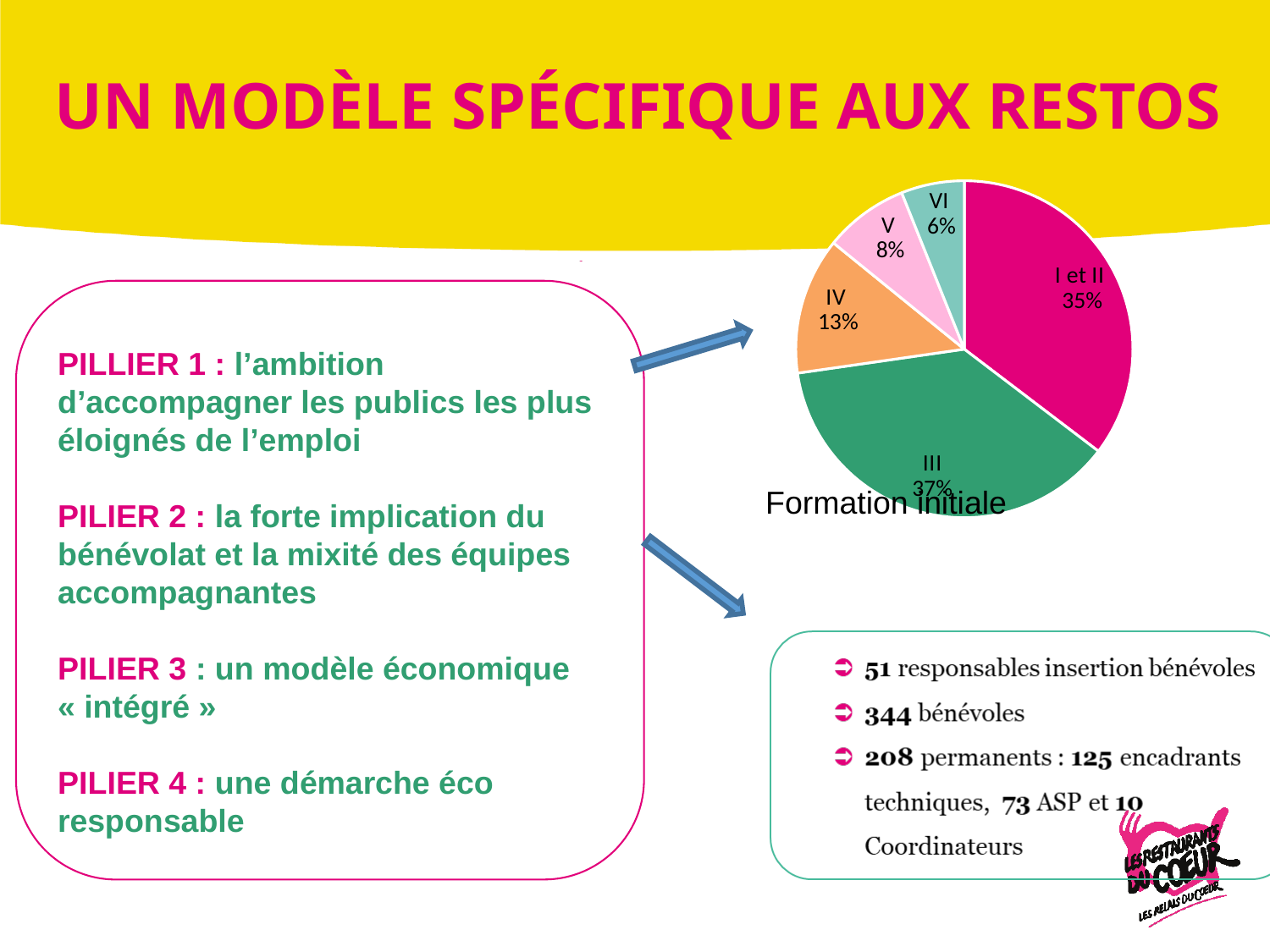
What is the difference in percentage points between the "IV" slice and the "V" slice? 5 Which slice of the pie chart is the largest? III What share of the pie does the slice labelled "VI" represent? 6% Which slice of the pie chart is the smallest? VI What kind of chart is shown on the slide? pie chart What share of the pie does the slice labelled "III" represent? 37% What share of the pie does the slice labelled "IV" represent? 13% Which slice is larger, "IV" or "VI"? IV What is the title shown below the pie chart? Formation initiale How many slices does the pie chart have? 5